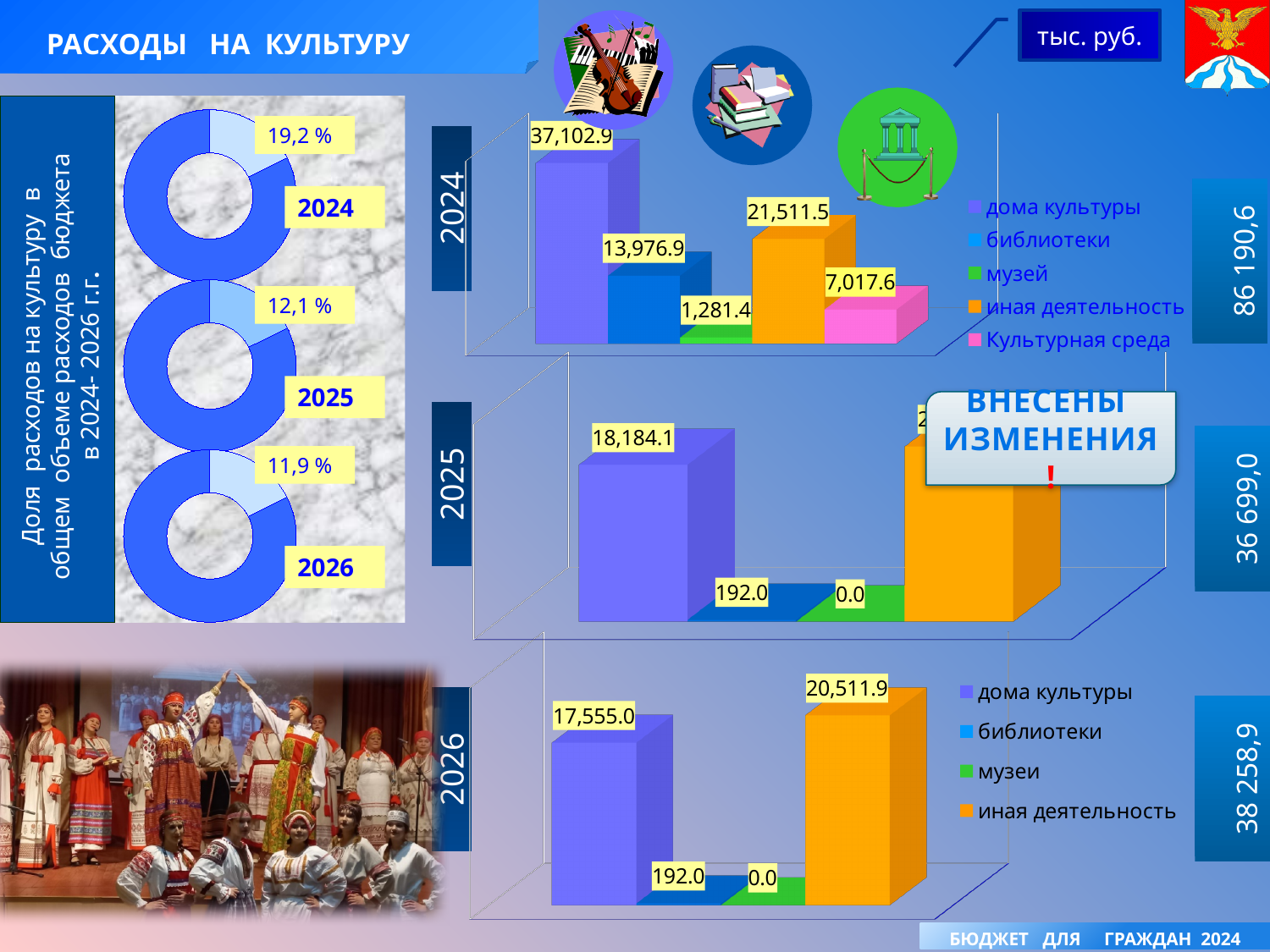
In the 2026 bar chart, what is the value for иная деятельность? 20,511.9 In the 2026 bar chart, which is larger: дома культуры or иная деятельность? иная деятельность In the 2024 bar chart, which category has the highest value? дома культуры How many series does the legend of the 2024 bar chart list? 5 In the 2024 bar chart, what is the value for дома культуры? 37,102.9 In the 2026 bar chart, what is the difference between иная деятельность and дома культуры? 2,956.9 In the 2024 bar chart, what is the difference between библиотеки and Культурная среда? 6,959.3 In the 2025 bar chart, what is the value for дома культуры? 18,184.1 In the 2025 bar chart, what is the value for музей? 0.0 What kind of chart is used to show the 2026 expenditure breakdown? bar chart In the donut chart for 2024 on the left, what share of budget expenditures goes to culture? 19,2 % In the 2024 bar chart, which category has the lowest value? музей